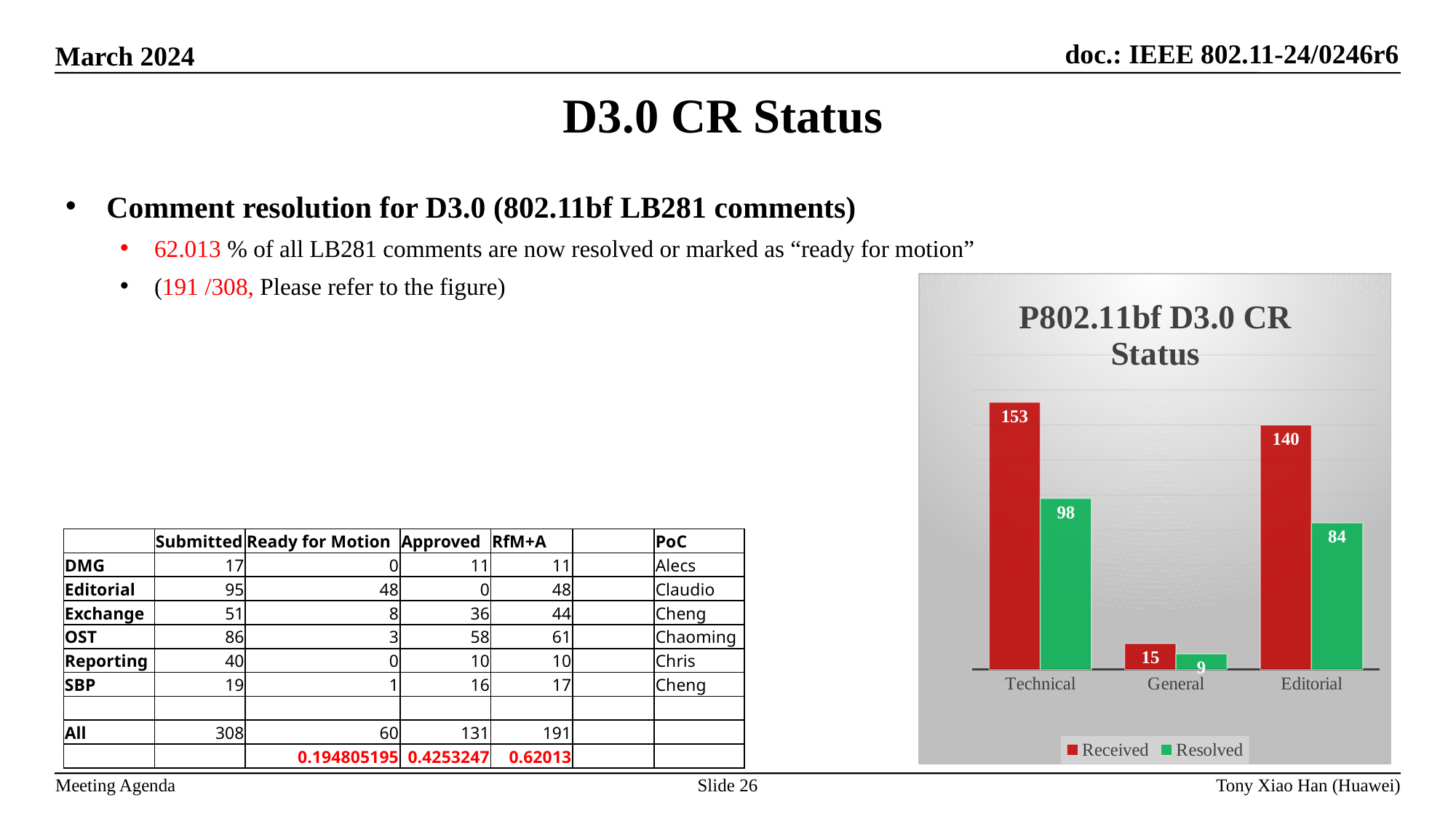
What is the difference between Received and Resolved for Technical? 55 Which category has the lowest Resolved value? General What is the difference between Received and Resolved for Editorial? 56 What is the title of the chart? P802.11bf D3.0 CR Status What is the Resolved value for Editorial? 84 What kind of chart is shown? bar chart Which category has the highest Received value? Technical What is the Resolved value for General? 9 What is the Received value for Technical? 153 How many categories are shown on the x axis? 3 How many series does the legend list? 2 Which is larger, the Resolved value for Technical or the Resolved value for Editorial? Technical